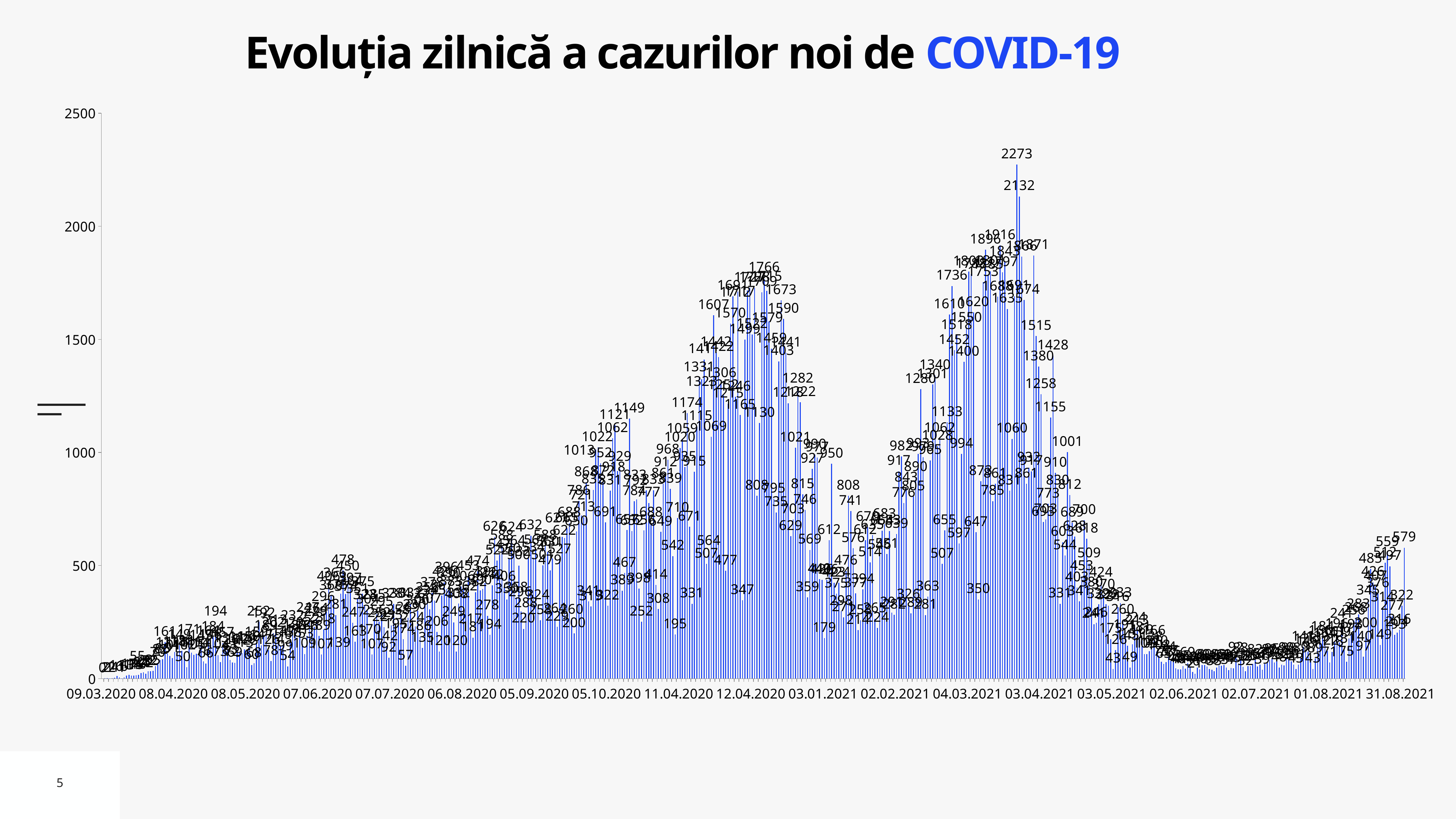
Which is taller: the tallest bar near 03.04.2021 or the tallest bar near 12.04.2020? the tallest bar near 03.04.2021 What is the difference between the two highest labeled values, 2273 and 2132? 141 What is the first date shown on the x axis? 09.03.2020 What is the highest daily value labeled on the chart? 2273 Are the daily values around 02.06.2021 greater or less than 500? less What is the title of the chart? Evoluția zilnică a cazurilor noi de COVID-19 Is the highest bar on the chart greater or less than 2000? greater What is the second highest daily value labeled on the chart, just below the peak of 2273? 2132 What kind of chart is shown on the slide? bar chart Between 02.06.2021 and 31.08.2021, do the daily values generally rise or fall? rise Between 03.04.2021 and 02.06.2021, do the daily values generally rise or fall? fall